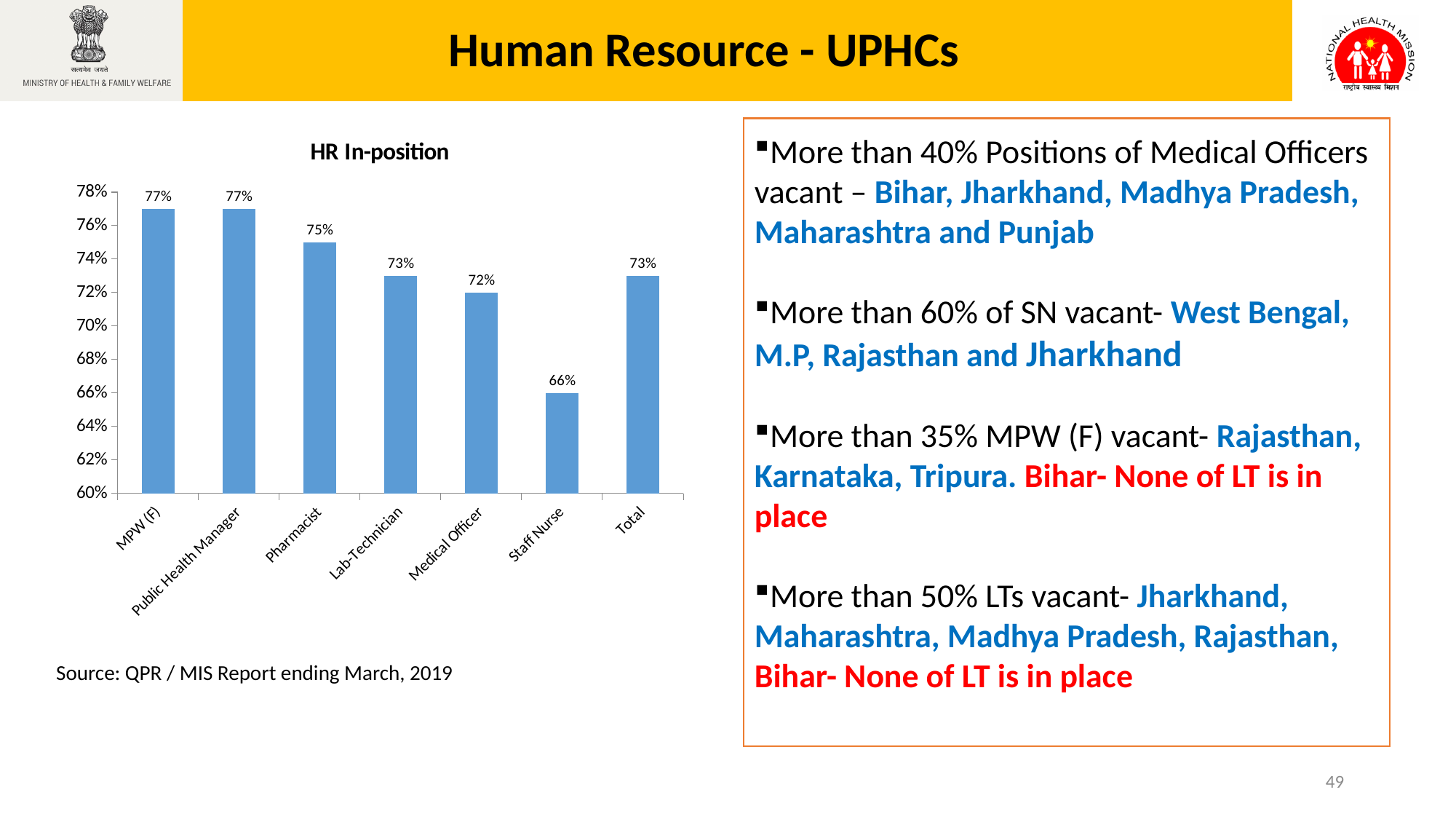
What is the title of the chart? HR In-position What is the HR in-position value for Total? 73% What is the difference between the HR in-position values for Lab-Technician and Medical Officer? 1% What is the HR in-position value for Staff Nurse? 66% Is the HR in-position value for Staff Nurse greater or less than 70%? less What kind of chart is shown on the slide? bar chart Which category has the lowest HR in-position value? Staff Nurse Which is larger, the HR in-position value for Pharmacist or for Medical Officer? Pharmacist What is the HR in-position value for Medical Officer? 72% How many categories are shown on the x axis of the chart? 7 What is the HR in-position value for Pharmacist? 75% What is the difference between the HR in-position values for Pharmacist and Staff Nurse? 9%